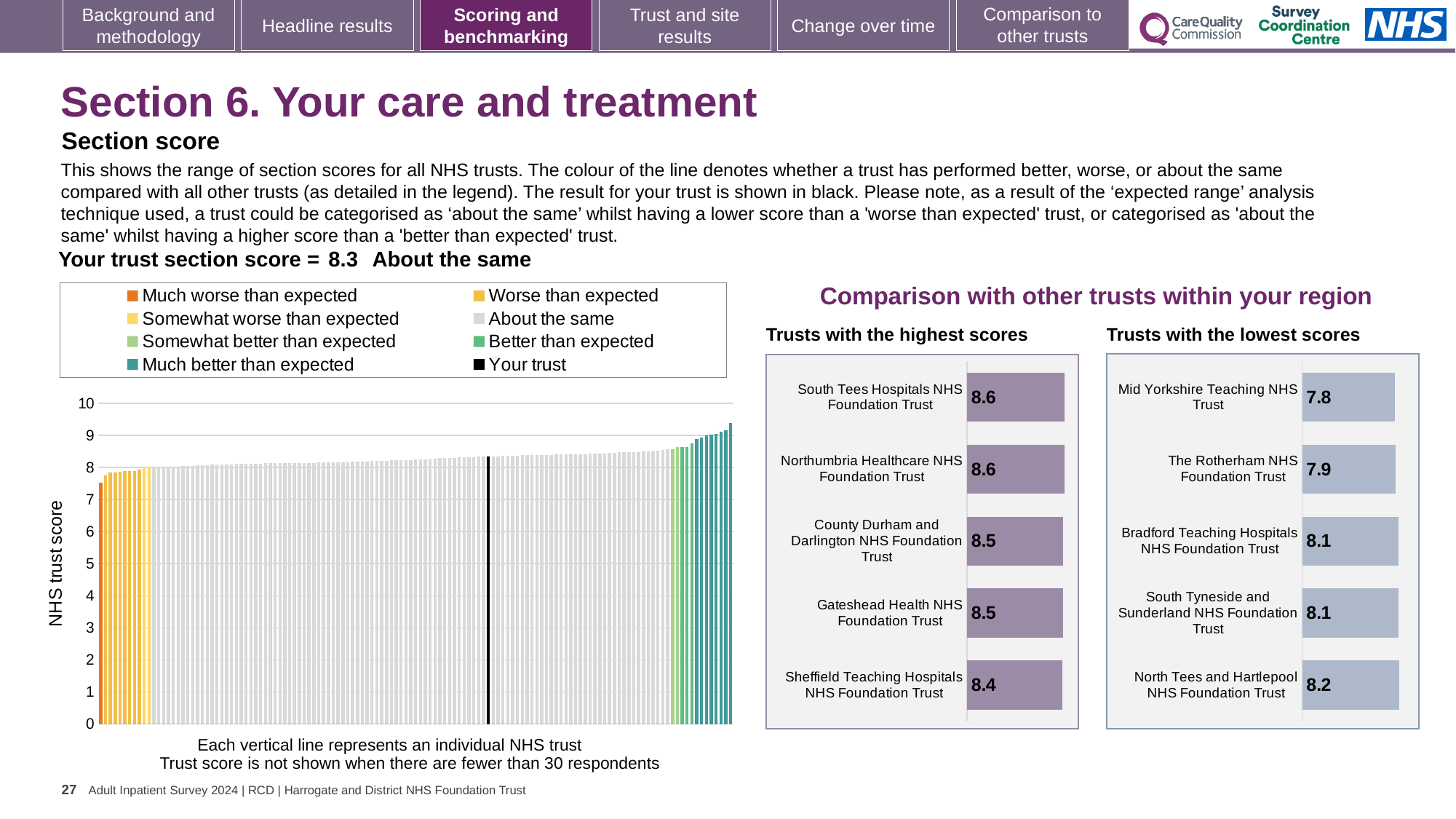
Which has the higher score: Gateshead Health NHS Foundation Trust on the highest-scores chart or The Rotherham NHS Foundation Trust on the lowest-scores chart? Gateshead Health NHS Foundation Trust On the 'Trusts with the lowest scores' chart, which trust has the lowest score? Mid Yorkshire Teaching NHS Trust On the 'Trusts with the highest scores' chart, what is the score for South Tees Hospitals NHS Foundation Trust? 8.6 On the 'Trusts with the highest scores' chart, what is the score for Sheffield Teaching Hospitals NHS Foundation Trust? 8.4 How many trusts are shown on the 'Trusts with the highest scores' chart? 5 How many entries does the legend of the large chart on the left list? 8 On the 'Trusts with the lowest scores' chart, which trust has the highest score? North Tees and Hartlepool NHS Foundation Trust On the 'Trusts with the lowest scores' chart, what is the score for Mid Yorkshire Teaching NHS Trust? 7.8 On the 'Trusts with the lowest scores' chart, what is the score for Bradford Teaching Hospitals NHS Foundation Trust? 8.1 What kind of chart is the large chart on the left showing NHS trust scores? Bar chart On the 'Trusts with the highest scores' chart, which trust has the lowest score? Sheffield Teaching Hospitals NHS Foundation Trust What is the difference between the score for North Tees and Hartlepool NHS Foundation Trust and the score for Mid Yorkshire Teaching NHS Trust on the 'Trusts with the lowest scores' chart? 0.4